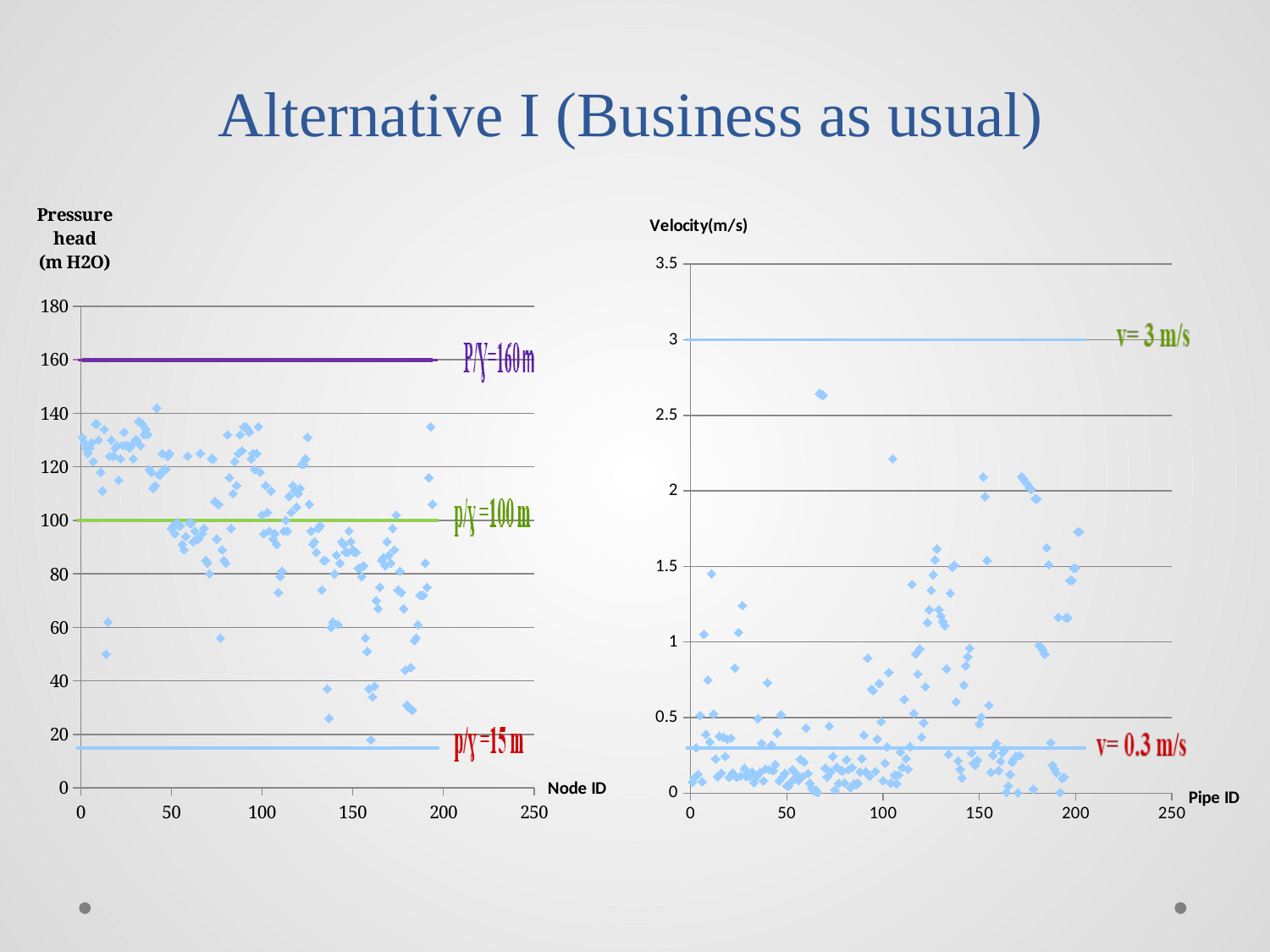
On the left chart (Pressure head), is the highest plotted point greater or less than 160? less On the right chart (Velocity), what value does the upper reference line mark? 3 m/s On the right chart (Velocity), is the highest plotted point greater or less than 3? less On the left chart (Pressure head), what is the difference between the upper (160 m) and lower (15 m) reference lines? 145 m On the right chart (Velocity), what is the difference between the two reference lines (3 m/s and 0.3 m/s)? 2.7 m/s On the left chart (Pressure head), what value does the upper purple reference line mark? 160 m What is the x-axis label of the right chart? Pipe ID On the right chart (Velocity), what value does the lower reference line mark? 0.3 m/s On the left chart (Pressure head), what value does the lowest reference line mark? 15 m On the right chart (Velocity), is the highest plotted point greater or less than 2.5? greater On the left chart (Pressure head), what value does the green reference line mark? 100 m What kind of chart is the left chart (Pressure head vs Node ID)? scatter chart